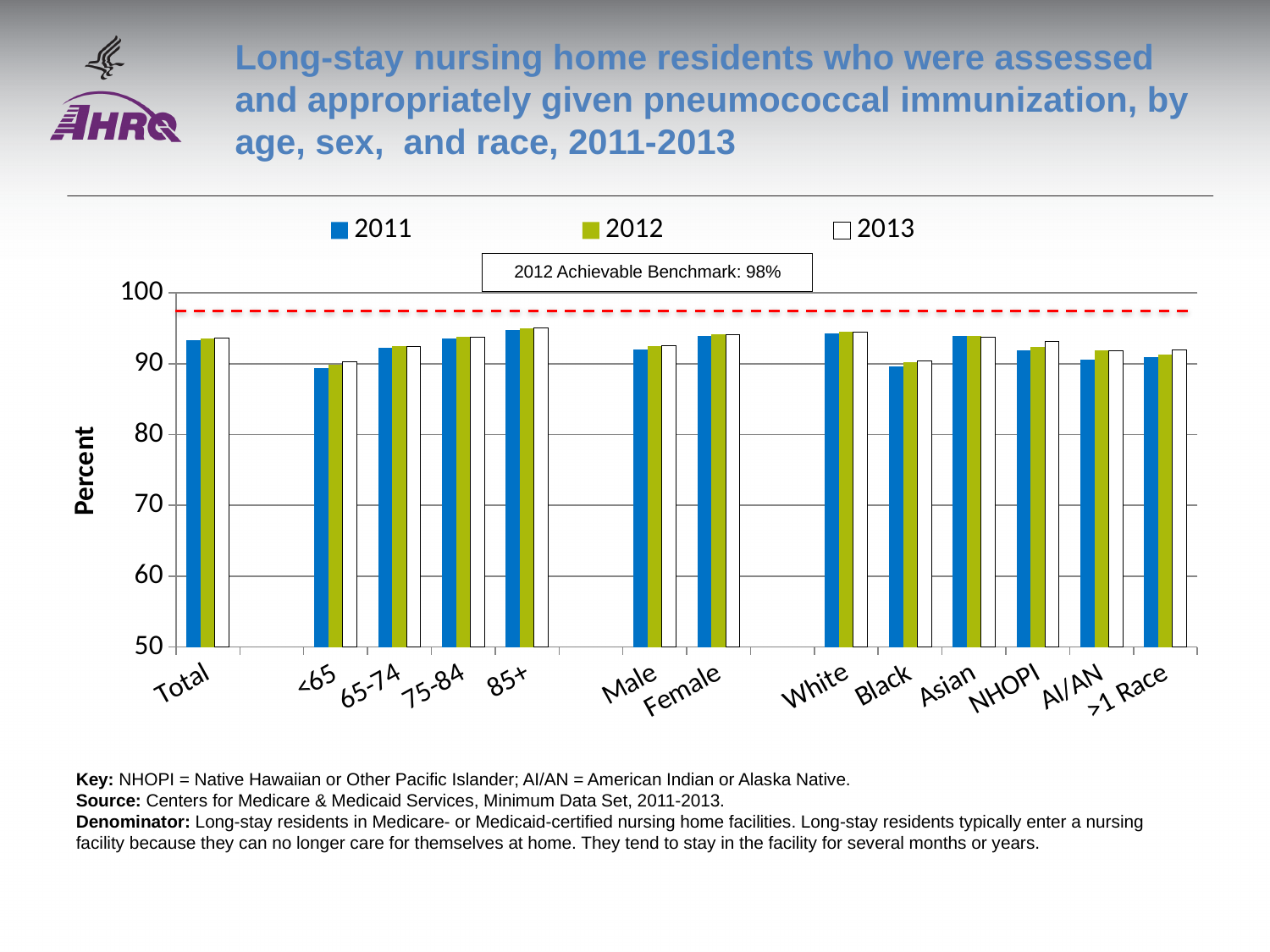
How many categories are shown along the x axis? 13 Which years are listed in the legend? 2011, 2012, 2013 What kind of chart is shown on the slide? Bar chart Is the 2011 value for <65 greater or less than 90? less Among the age groups (<65, 65-74, 75-84, 85+), which has the highest 2013 value? 85+ In 2011, which is larger, the value for White or the value for Black? White Is the 2012 value for Total greater or less than 90? greater How many series does the legend list? 3 Is the 2013 value for 85+ greater or less than 90? greater What is the 2012 achievable benchmark shown on the chart? 98% Among the age groups (<65, 65-74, 75-84, 85+), which has the lowest 2011 value? <65